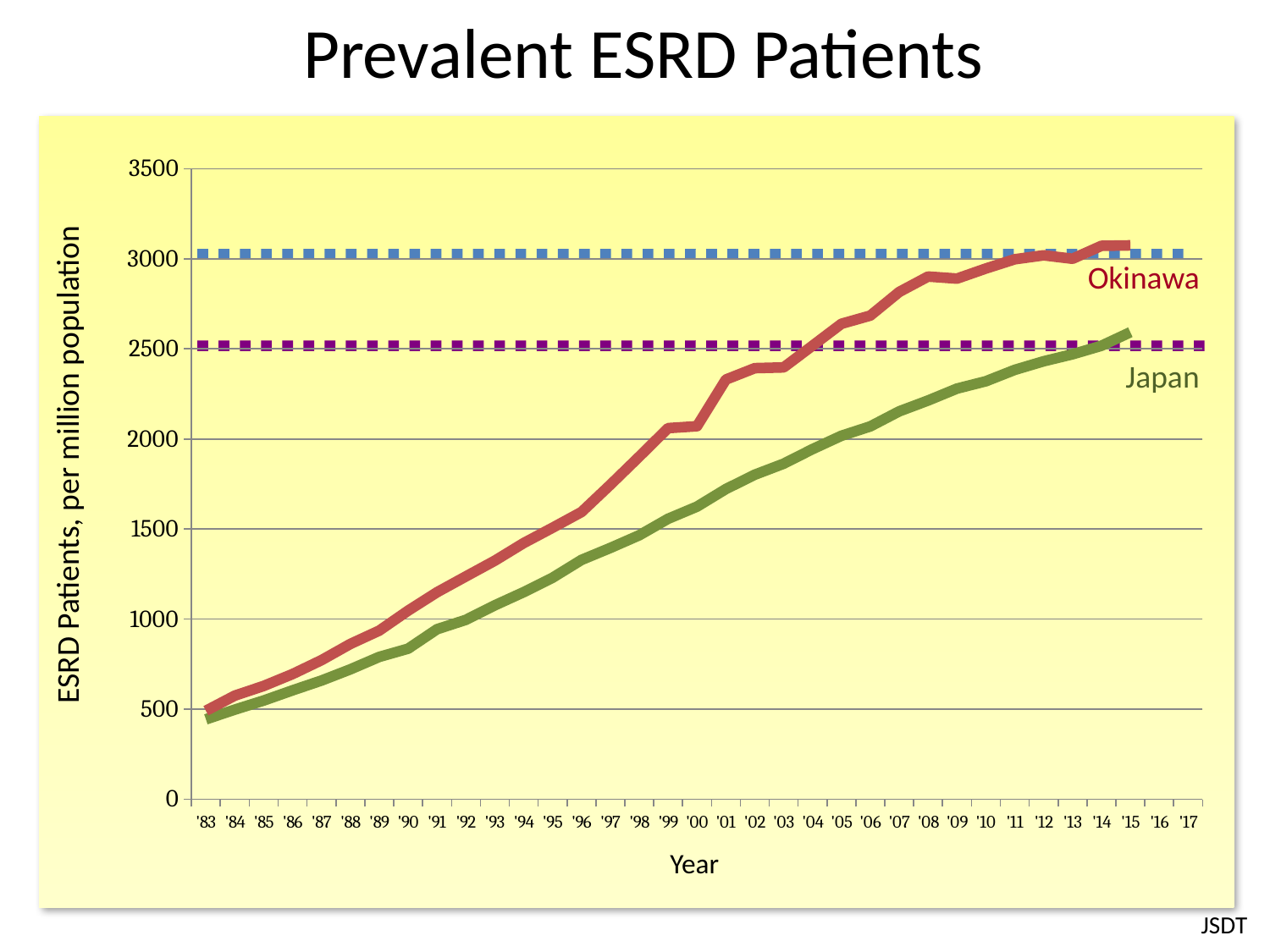
What is the title of the chart? Prevalent ESRD Patients Is the value for Japan in '08 greater or less than 2500? less Is the value for Okinawa in '01 greater or less than 2000? greater Is the value for Japan in '00 greater or less than 2000? less How many year labels are shown along the x axis? 35 What is the label on the vertical axis of the chart? ESRD Patients, per million population Which series reaches the higher value by the end of the plotted period, Okinawa or Japan? Okinawa In '05, which is larger, the value for Okinawa or the value for Japan? Okinawa Do the values for Japan rise or fall from '83 to '15? rise What kind of chart is shown on the slide? line chart Which series has the lower value in '10, Okinawa or Japan? Japan